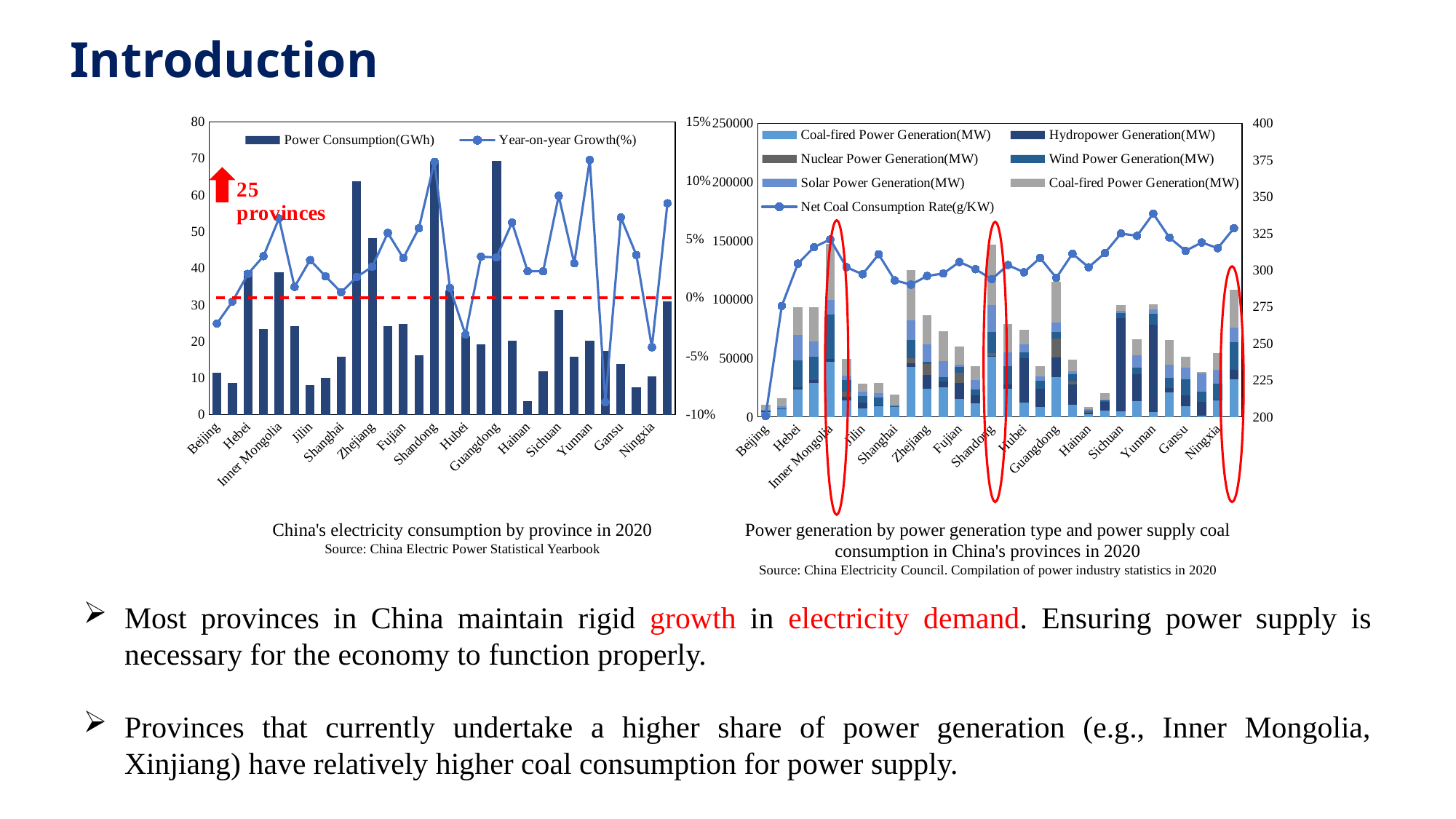
In the left chart, is the Power Consumption bar for Zhejiang greater or less than 60? less In the right chart, is the total stacked bar for Inner Mongolia greater or less than 100000? greater In the right chart, which labelled province has the lowest Net Coal Consumption Rate point? Beijing What kind of chart is the right chart, 'Power generation by power generation type and power supply coal consumption in China's provinces in 2020'? A stacked bar chart combined with a line chart What kind of chart is the left chart, 'China's electricity consumption by province in 2020'? A bar chart combined with a line chart In the left chart, what text appears next to the red upward arrow? 25 provinces In the left chart, is the Year-on-year Growth value for Gansu greater or less than -5%? greater In the left chart, which labelled province has the lowest Power Consumption bar? Hainan In the right chart, how many series does the legend list? 7 In the left chart, how many series does the legend list? 2 In the left chart, which has the larger Power Consumption bar, Zhejiang or Fujian? Zhejiang